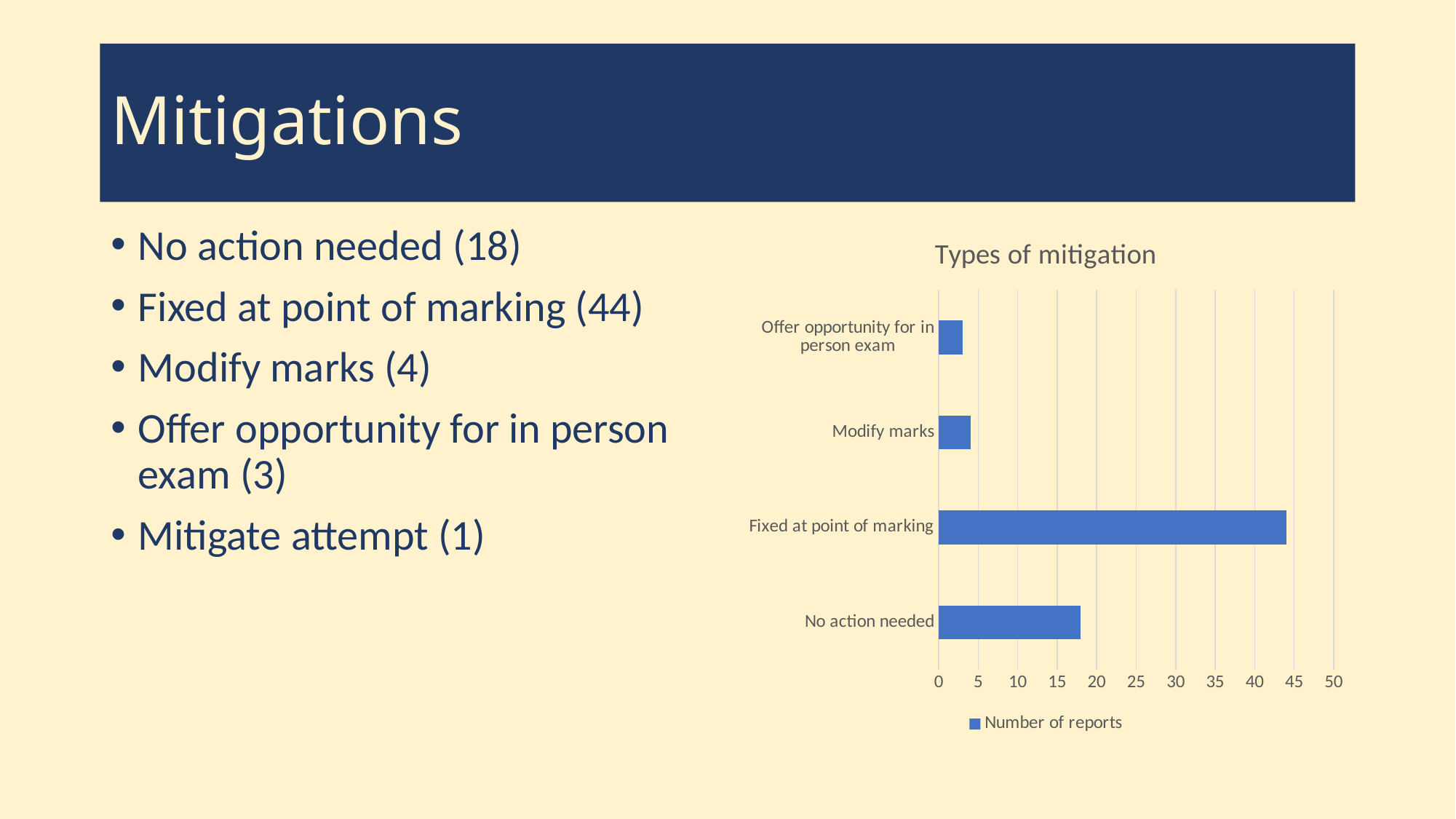
What is the number of reports for "Modify marks"? 4 How many series does the legend of the "Types of mitigation" chart list? 1 What is the difference in number of reports between "Fixed at point of marking" and "No action needed"? 26 What is the name of the series in the legend of the "Types of mitigation" chart? Number of reports How many categories are plotted in the "Types of mitigation" chart? 4 Which category has the highest number of reports in the "Types of mitigation" chart? Fixed at point of marking What is the number of reports for "No action needed"? 18 Which category has the lowest number of reports in the "Types of mitigation" chart? Offer opportunity for in person exam Which has more reports, "Modify marks" or "No action needed"? No action needed What is the number of reports for "Fixed at point of marking"? 44 Is the number of reports for "No action needed" greater or less than 20? less What type of chart is shown under the title "Types of mitigation"? bar chart